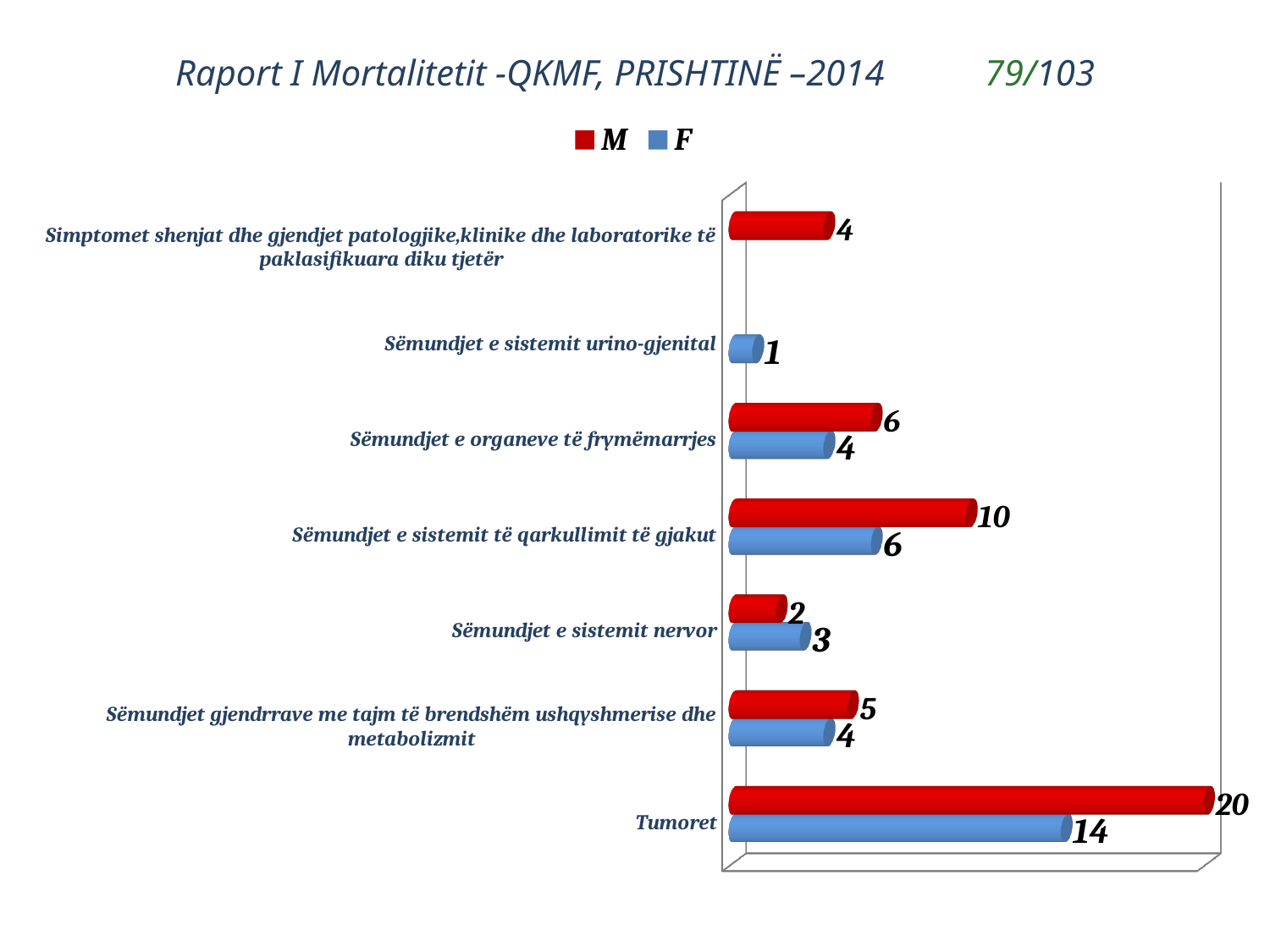
Which category has the highest M value? Tumoret What is the F value for Sëmundjet e sistemit urino-gjenital? 1 How many categories are shown on the chart? 7 What is the F value for Tumoret? 14 What is the F value for Sëmundjet e sistemit nervor? 3 What is the M value for Tumoret? 20 What is the M value for Sëmundjet e sistemit të qarkullimit të gjakut? 10 What is the difference between the M and F values for Tumoret? 6 Which category has the lowest M value among those with an M bar? Sëmundjet e sistemit nervor How many series does the legend list? 2 What type of chart is shown on the slide? Bar chart For Sëmundjet e sistemit nervor, which is larger, the M value or the F value? F